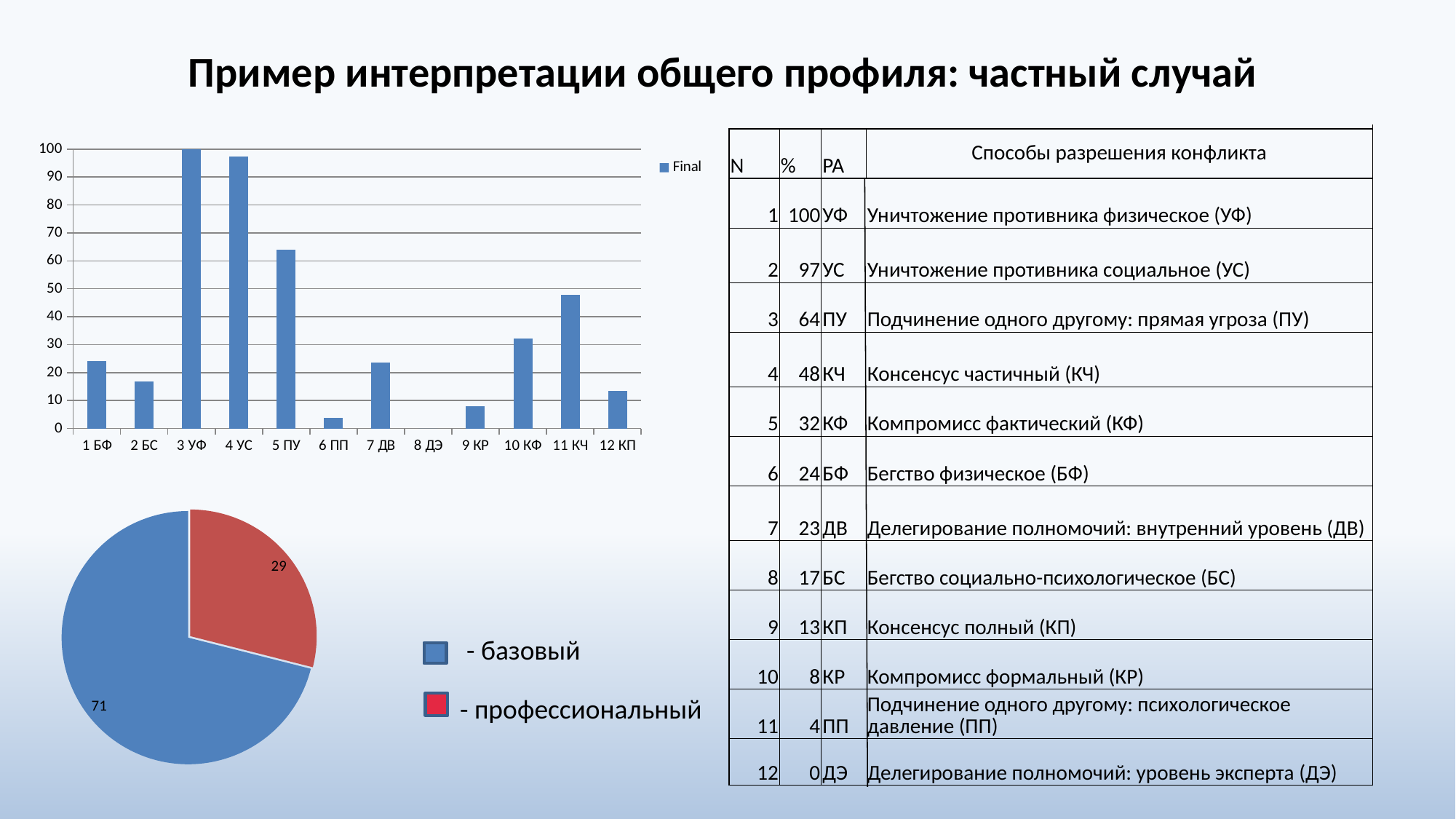
In the bottom-left pie chart, what share of the whole does the blue slice (базовый) represent? 71% In the top-left bar chart, how many series does the legend list? 1 In the top-left bar chart, which category has the lowest value? 8 ДЭ In the top-left bar chart, which is larger, the value for 5 ПУ or the value for 11 КЧ? 5 ПУ What kind of chart is the top-left chart on the slide? bar chart In the top-left bar chart, which category has the highest bar? 3 УФ In the bottom-left pie chart, what is the value of the red slice (профессиональный)? 29 In the top-left bar chart, how many categories are shown on the x axis? 12 In the top-left bar chart, what is the value for 3 УФ? 100 In the top-left bar chart, what is the name of the series shown in the legend? Final In the top-left bar chart, is the value for 5 ПУ greater or less than 60? greater In the top-left bar chart, is the value for 6 ПП greater or less than 10? less